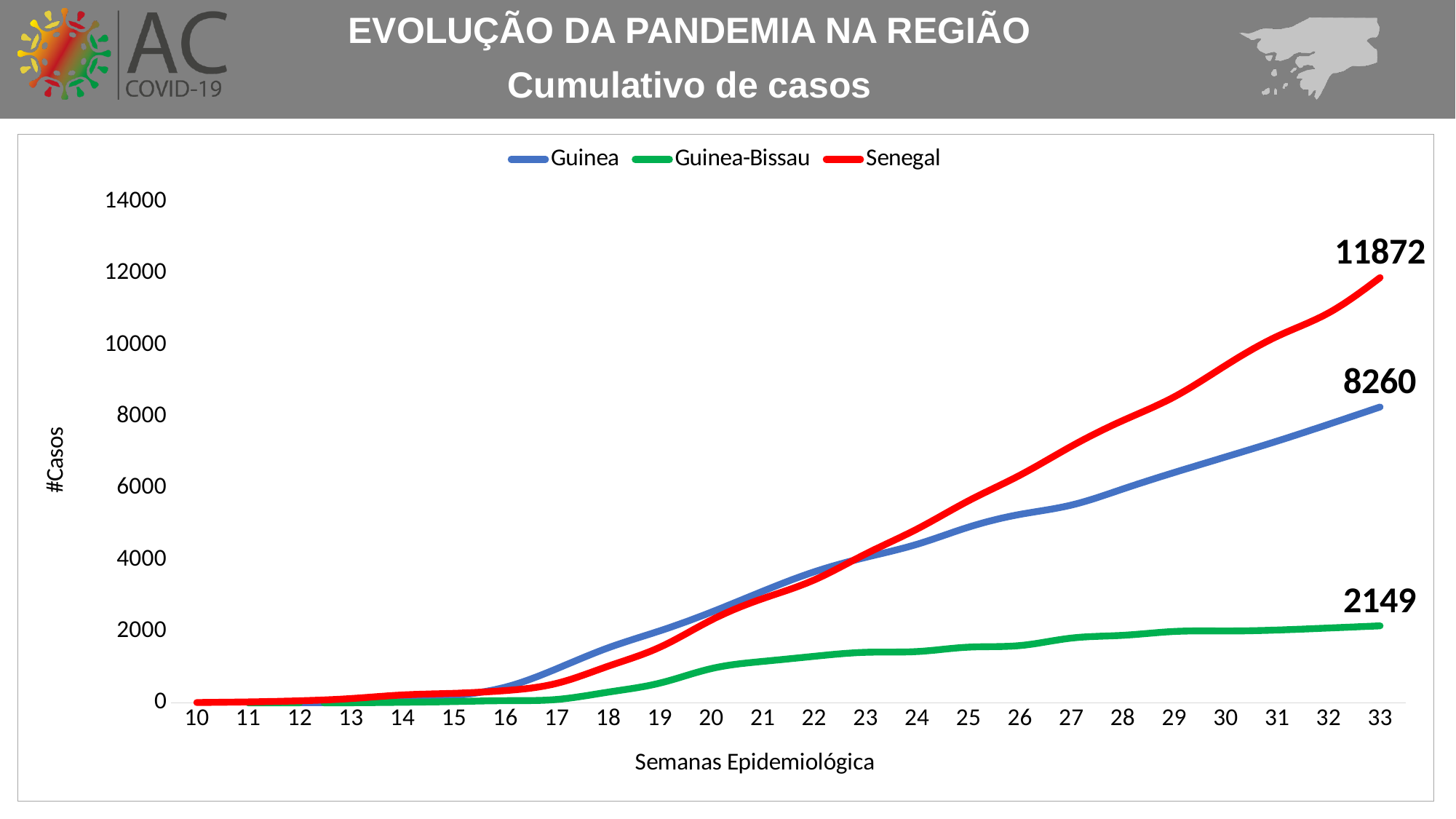
Which country has the lowest cumulative number of cases at week 33? Guinea-Bissau Do the cumulative case values for Senegal rise or fall from week 10 to week 33? Rise What is the difference between the cumulative cases of Senegal and Guinea at week 33? 3612 What is the cumulative number of cases for Guinea-Bissau at week 33? 2149 Is the value for Senegal at week 25 greater or less than 4000? greater Which country has the highest cumulative number of cases at week 33? Senegal What is the cumulative number of cases for Guinea at week 33? 8260 What kind of chart is shown on the slide? Line chart How many series does the legend list? 3 At week 33, which has more cumulative cases, Guinea or Guinea-Bissau? Guinea What is the difference between the cumulative cases of Guinea and Guinea-Bissau at week 33? 6111 What is the cumulative number of cases for Senegal at week 33? 11872